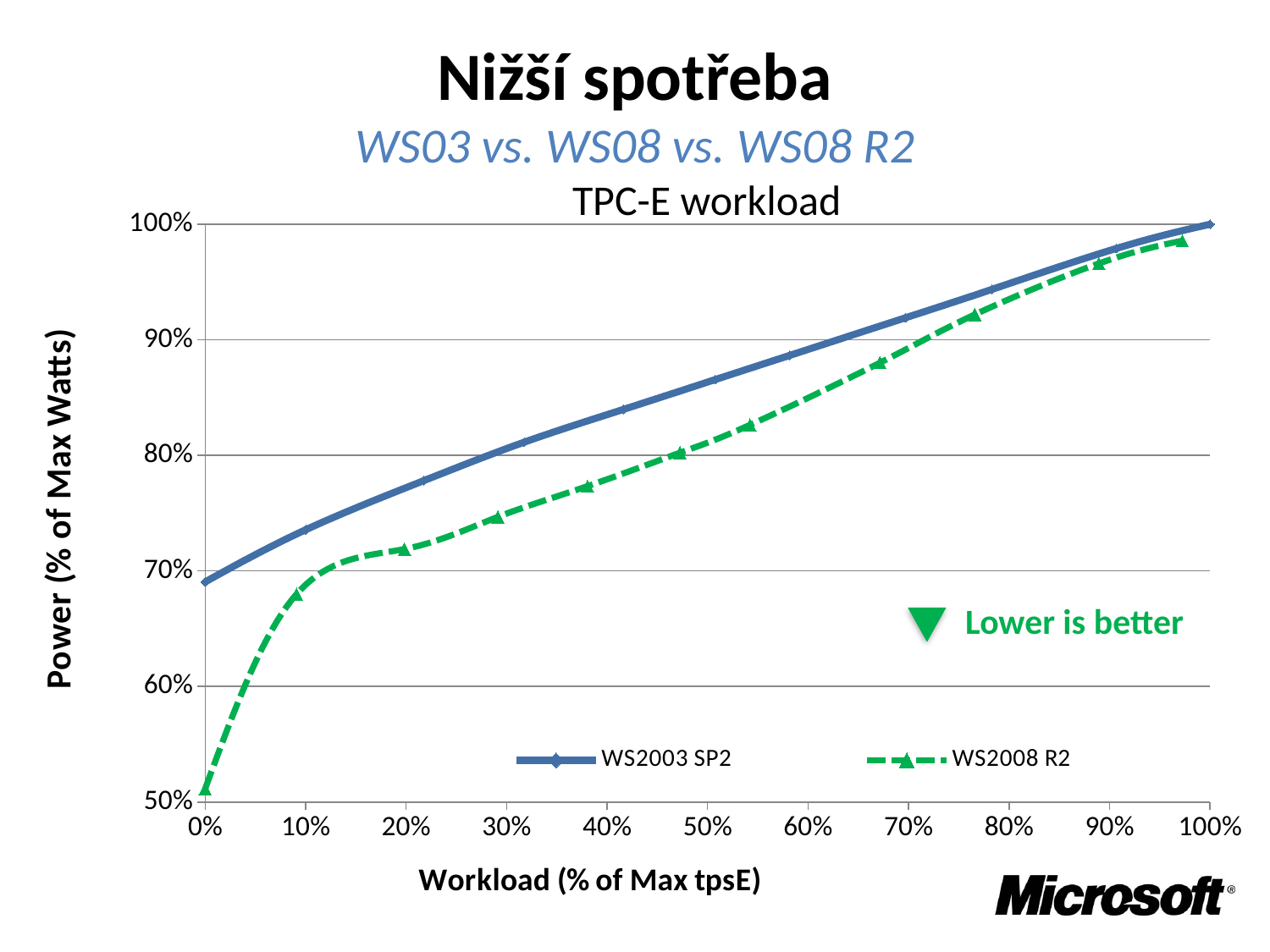
At 50% workload, which series shows the higher power: WS2003 SP2 or WS2008 R2? WS2003 SP2 Does the power for WS2008 R2 rise or fall as workload increases along the x axis? rise What kind of chart is shown on the slide? line chart How many series does the legend list? 2 Is the power for WS2003 SP2 at 50% workload greater or less than 80%? greater Is the power for WS2003 SP2 at 0% workload greater or less than 60%? greater What are the two series named in the legend? WS2003 SP2 and WS2008 R2 Does the power for WS2003 SP2 rise or fall as workload increases along the x axis? rise What is the title shown directly above the chart? TPC-E workload Is the power for WS2008 R2 at 0% workload greater or less than 60%? less What is the power value for WS2003 SP2 at 100% workload? 100%